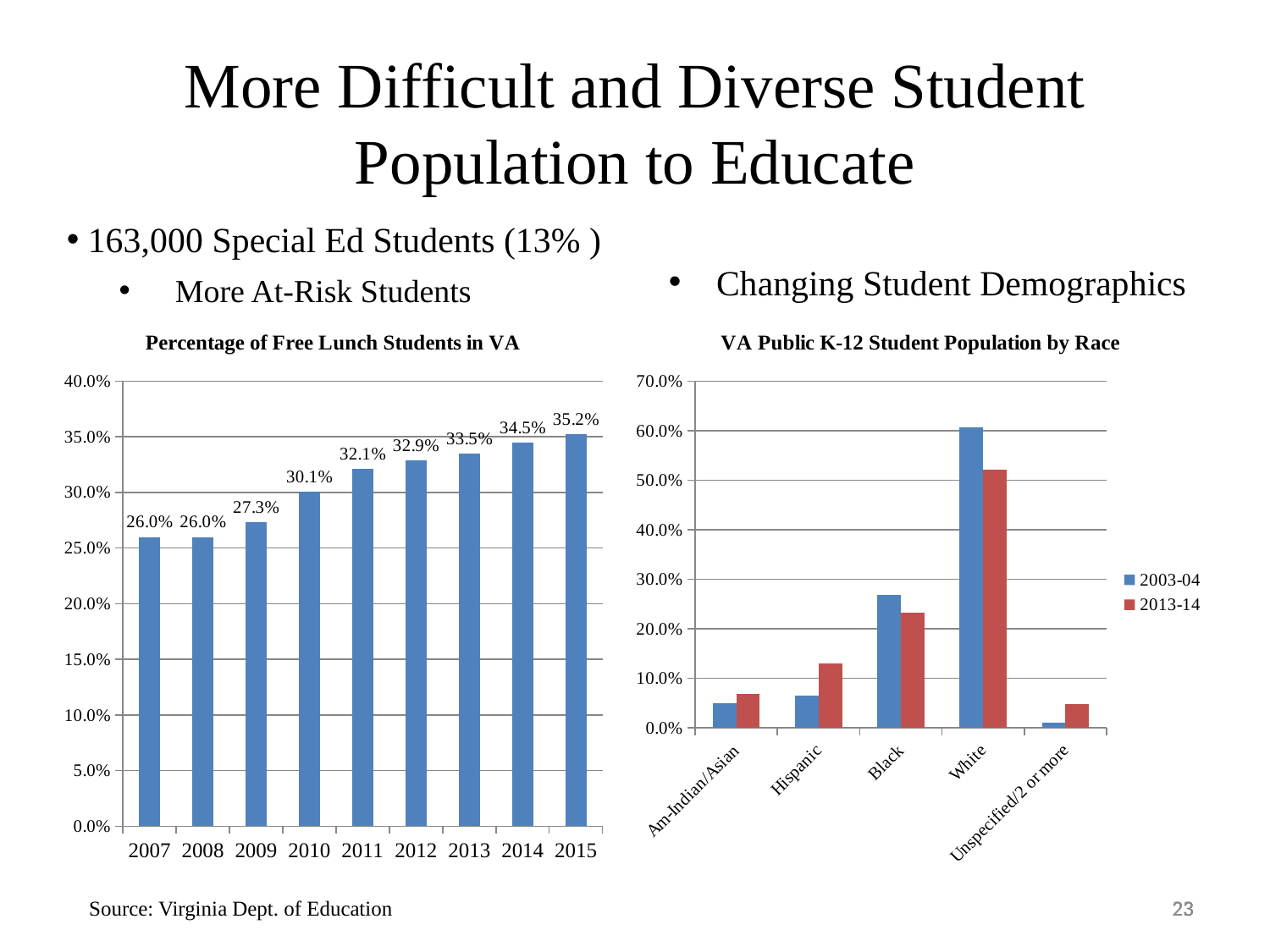
In the 'VA Public K-12 Student Population by Race' chart, which is larger for Black: the 2003-04 value or the 2013-14 value? 2003-04 In the 'VA Public K-12 Student Population by Race' chart, how many series does the legend list? 2 In the 'Percentage of Free Lunch Students in VA' chart, which year has the highest value? 2015 In the 'VA Public K-12 Student Population by Race' chart, which race category has the highest value for 2003-04? White In the 'VA Public K-12 Student Population by Race' chart, is the 2013-14 value for Hispanic greater or less than 10.0%? greater In the 'Percentage of Free Lunch Students in VA' chart, do the values rise or fall from 2007 to 2015? rise In the 'Percentage of Free Lunch Students in VA' chart, what is the value for 2010? 30.1% In the 'Percentage of Free Lunch Students in VA' chart, what is the value for 2015? 35.2% What type of chart is 'VA Public K-12 Student Population by Race'? bar chart In the 'Percentage of Free Lunch Students in VA' chart, how many years are shown on the x axis? 9 In the 'Percentage of Free Lunch Students in VA' chart, what is the difference between the 2015 and 2007 values? 9.2%